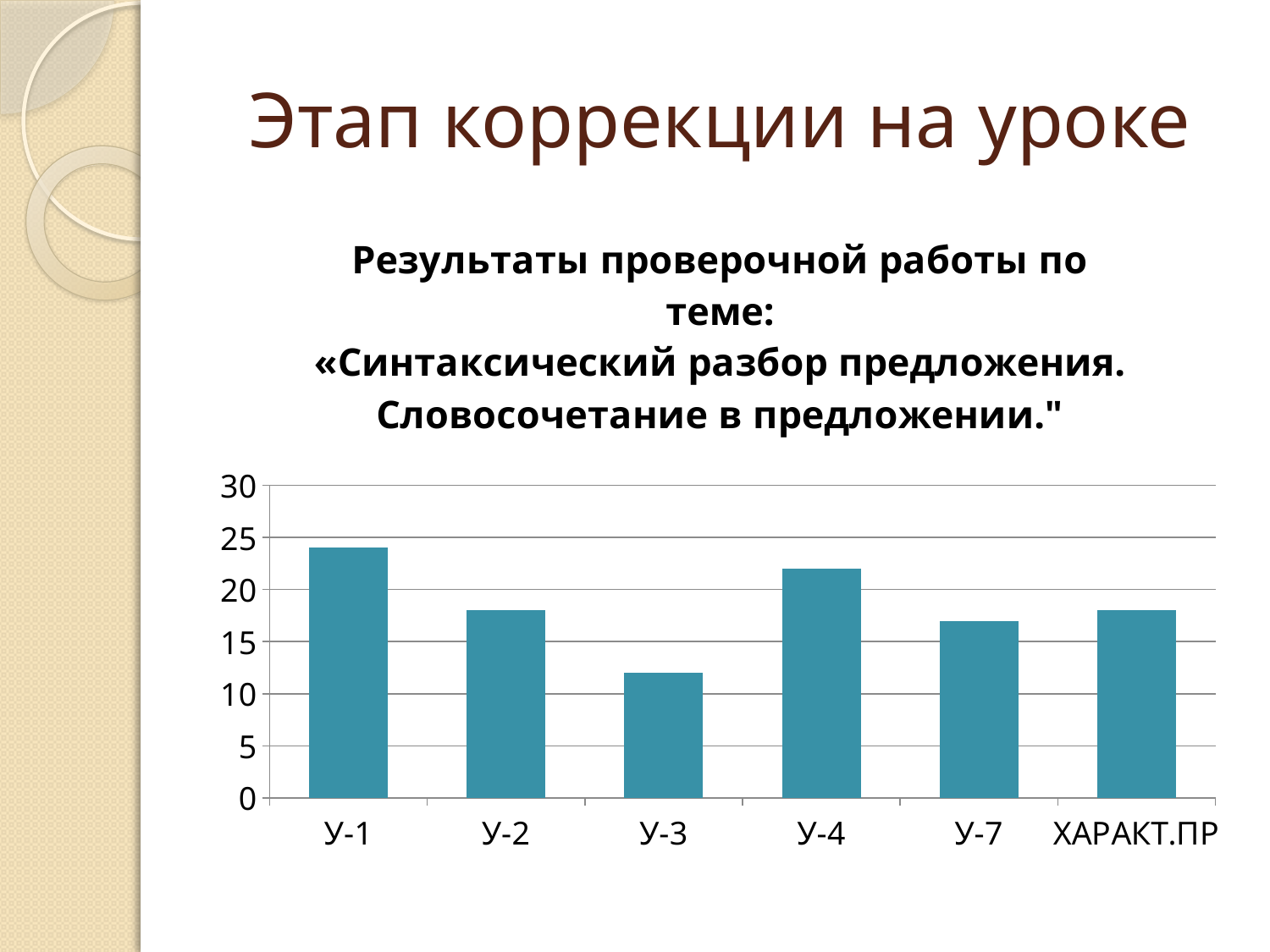
Is the value for У-4 greater or less than 20? greater Which category has the highest bar in the chart? У-1 Is the value for ХАРАКТ.ПР greater or less than 15? greater Which is larger, the value for У-7 or the value for У-3? У-7 Is the value for У-1 greater or less than 20? greater What kind of chart is shown on the slide? bar chart What is the label of the last category on the x axis of the chart? ХАРАКТ.ПР Which is larger, the value for У-4 or the value for У-2? У-4 Which category has the lowest bar in the chart? У-3 How many categories are shown on the x axis of the chart? 6